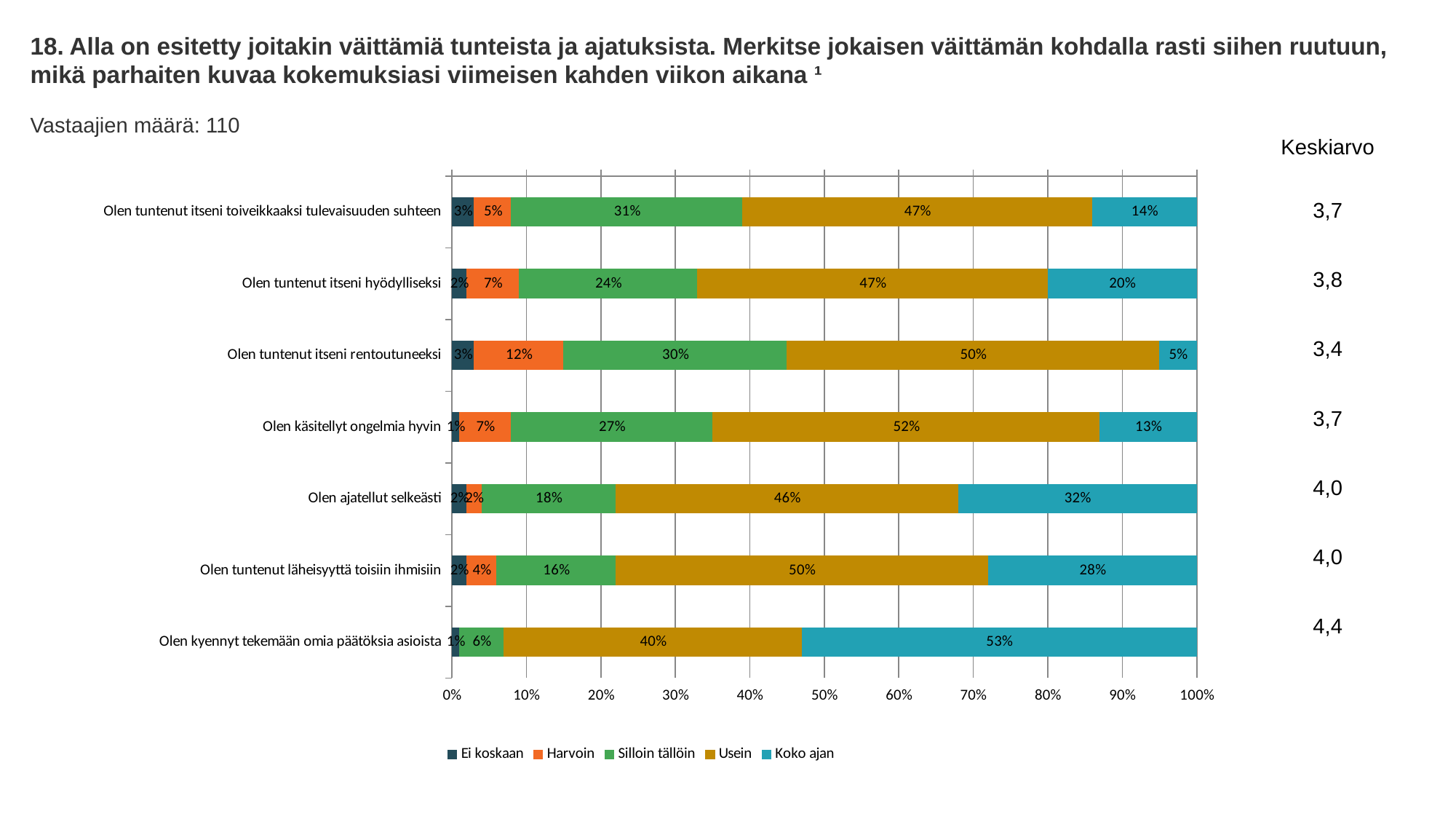
How many percentage points higher is the "Koko ajan" value for "Olen ajatellut selkeästi" than for "Olen tuntenut läheisyyttä toisiin ihmisiin"? 4 How many statements (bars) are shown in the chart? 7 Which statement has the highest "Koko ajan" share? Olen kyennyt tekemään omia päätöksiä asioista How many series does the legend list? 5 What is the Keskiarvo value shown for "Olen kyennyt tekemään omia päätöksiä asioista"? 4,4 What is the "Koko ajan" value for "Olen kyennyt tekemään omia päätöksiä asioista"? 53% What is the "Harvoin" value for "Olen tuntenut itseni rentoutuneeksi"? 12% What is the number of respondents (Vastaajien määrä) stated on the slide? 110 What percentage of respondents answered "Usein" for "Olen käsitellyt ongelmia hyvin"? 52% What kind of chart is shown on the slide? Stacked bar chart Which has the larger "Usein" value: "Olen tuntenut itseni rentoutuneeksi" or "Olen tuntenut itseni hyödylliseksi"? Olen tuntenut itseni rentoutuneeksi Which statement has the lowest "Koko ajan" share? Olen tuntenut itseni rentoutuneeksi